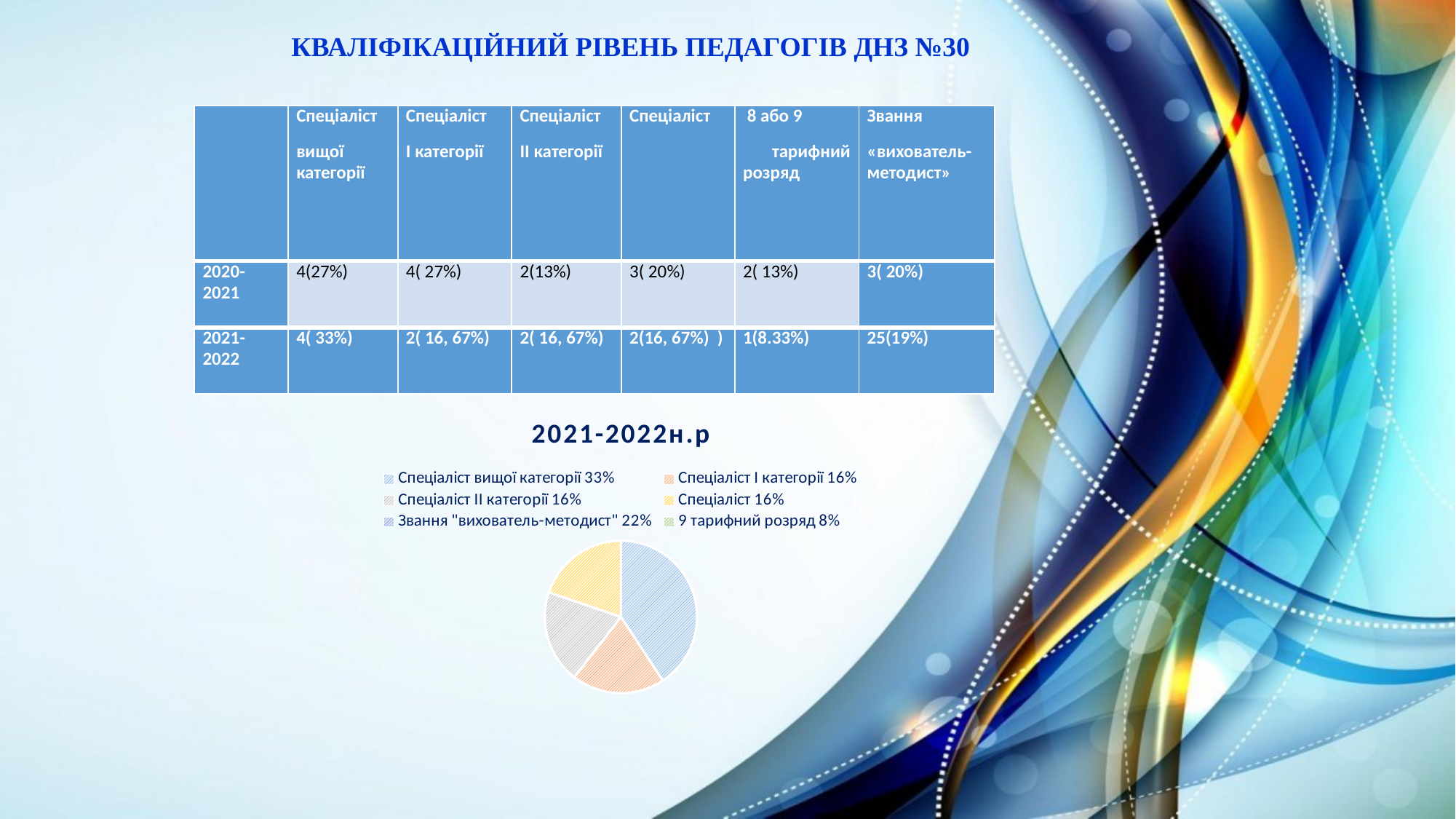
What is the title of the pie chart? 2021-2022н.р What share of the pie chart is 9 тарифний розряд? 8% What is the difference in percentage points between Спеціаліст вищої категорії and Спеціаліст II категорії in the pie chart? 17 What share of the pie chart is Спеціаліст вищої категорії? 33% Which has the larger share in the pie chart: 9 тарифний розряд or Спеціаліст I категорії? Спеціаліст I категорії How many categories does the pie chart's legend list? 6 Which has the larger share in the pie chart: Звання "вихователь-методист" or Спеціаліст 16%? Звання "вихователь-методист" What share of the pie chart is Спеціаліст I категорії? 16% Which category has the largest share in the pie chart? Спеціаліст вищої категорії Which category has the smallest share in the pie chart? 9 тарифний розряд What kind of chart is shown on the slide? pie chart